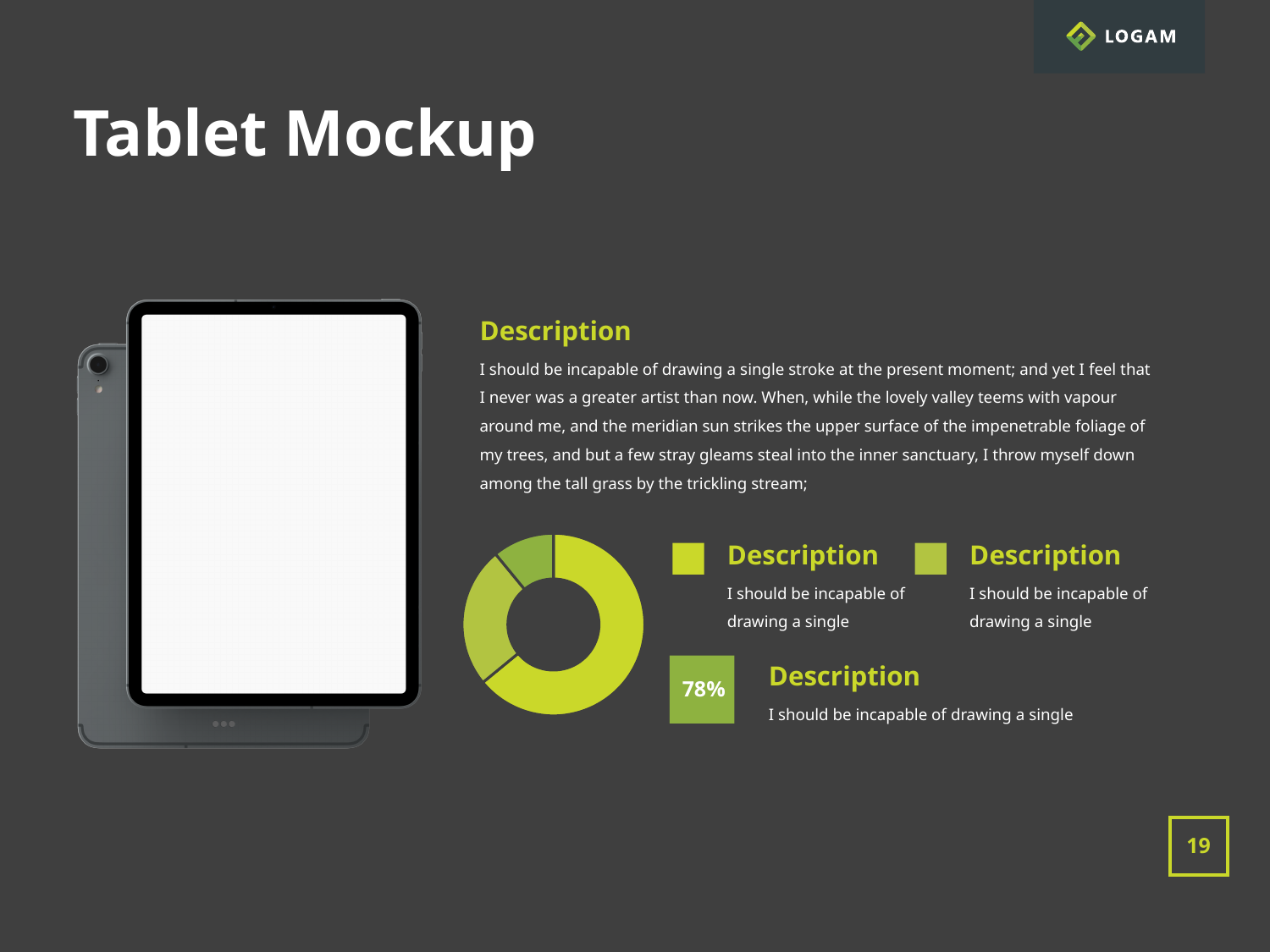
Does the donut chart display a legend with category names? No How many slices does the donut chart have? 3 What percentage is printed in the green box next to the donut chart? 78% Which slice of the donut chart is the largest? The bright yellow-green slice Is the bright yellow-green slice of the donut chart larger or smaller than the olive-green slice? Larger Does the largest slice of the donut chart cover more or less than half of the ring? More Which slice of the donut chart is the smallest? The dark green slice at the top left What kind of chart is shown on the slide? Donut (pie) chart